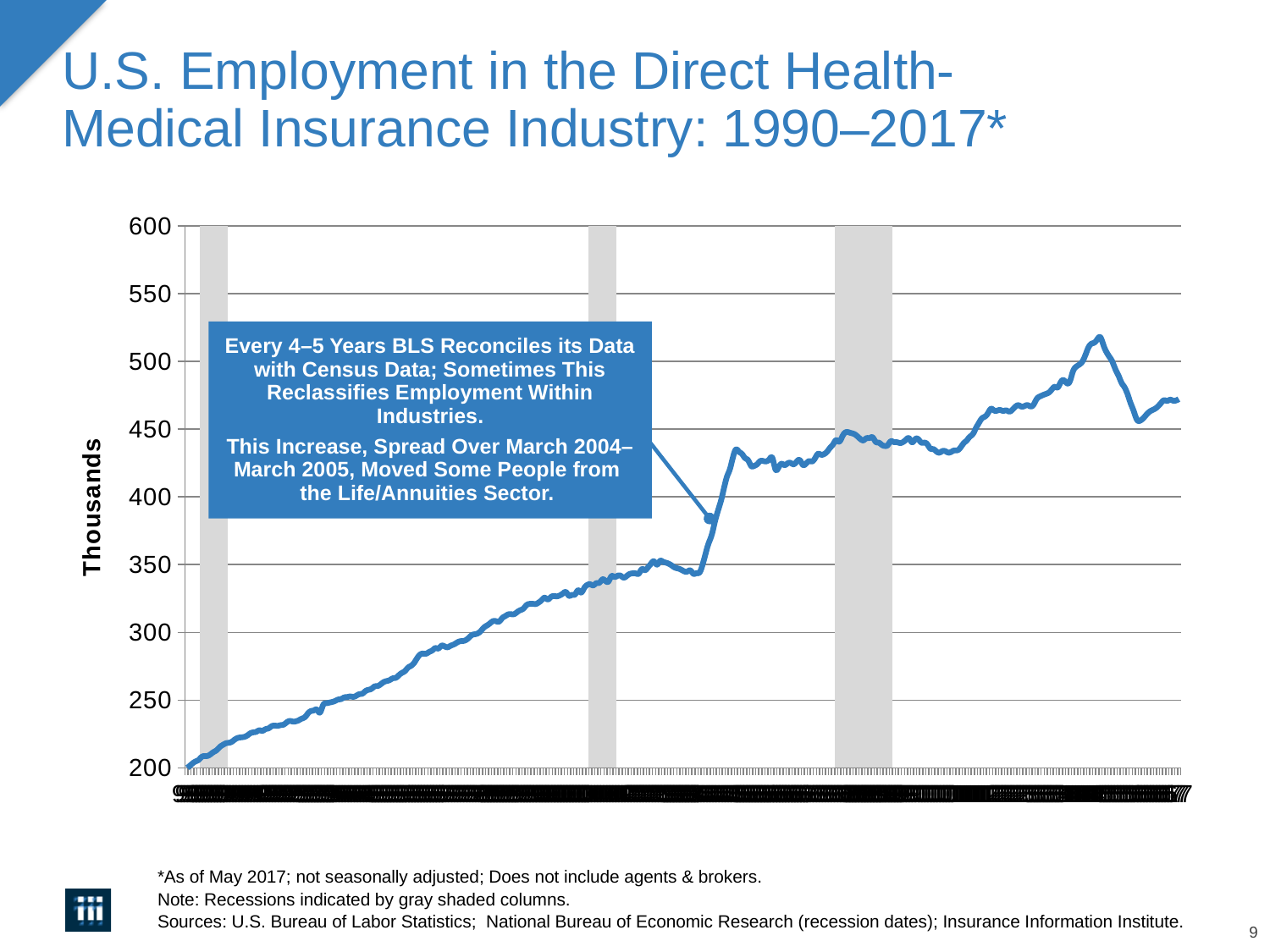
Is the value at the end of the series (right end of the line) greater or less than 500? less What kind of chart is shown on the slide? line chart Is the value at the start of the series (left end of the line) greater or less than 250? less What is the label on the vertical axis of the chart? Thousands What is the highest value shown on the vertical axis of the chart? 600 How many gray shaded recession columns appear on the chart? 3 Overall, do the values in the chart rise or fall from left to right along the x axis? rise Is the highest point reached by the line greater or less than 500? greater